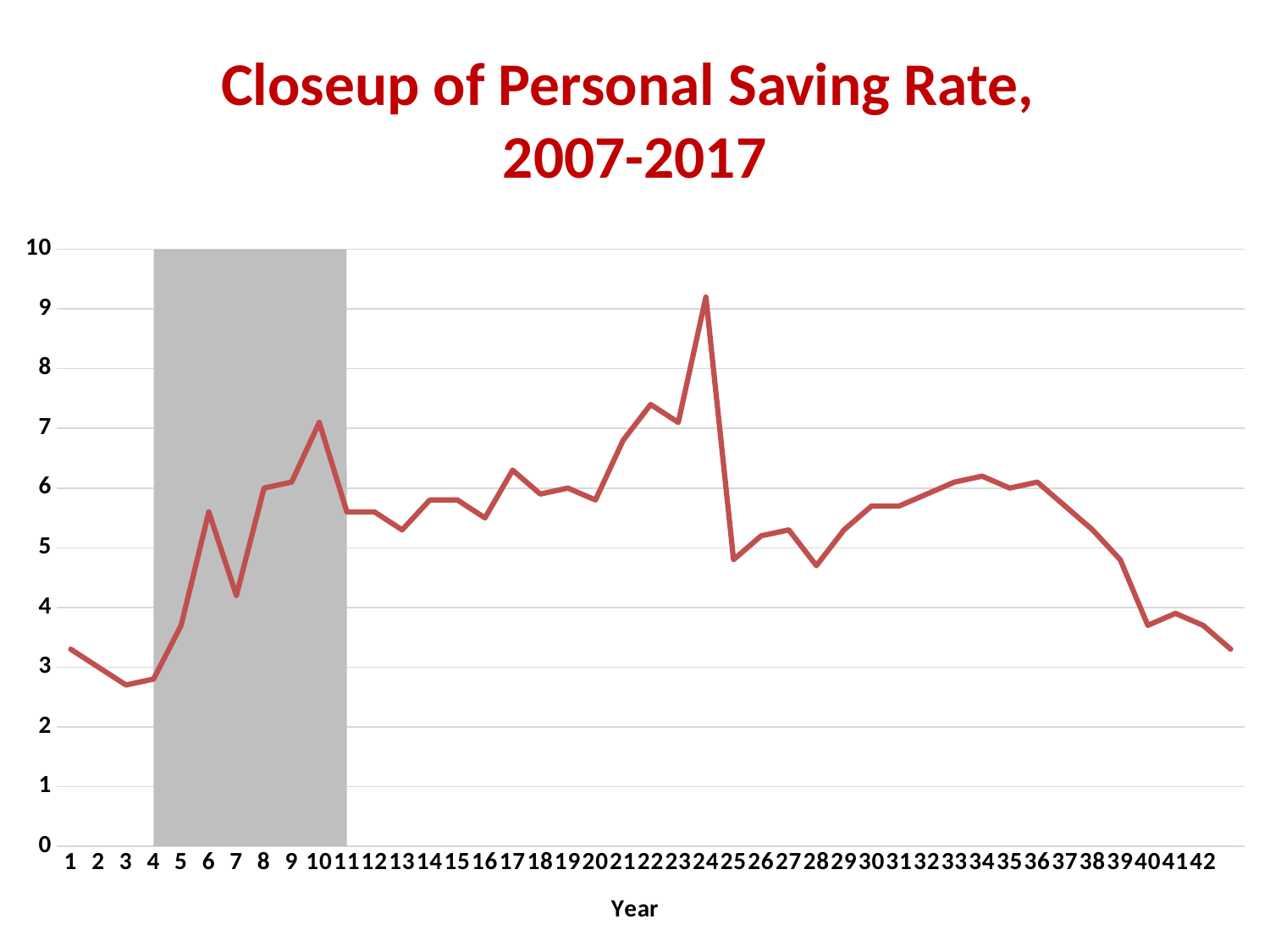
Is the value at point 28 greater or less than 5? less What is the label on the x axis? Year What kind of chart is shown on the slide? line chart Do the values rise or fall from point 36 to point 42? fall Is the value at point 24 greater or less than 8? greater At which x-axis point does the line reach its highest value? 24 What is the title of the chart? Closeup of Personal Saving Rate, 2007-2017 Which has the larger value, point 24 or point 10? point 24 How many points are plotted along the x axis? 43 Is the value at point 10 greater or less than 6? greater Which has the larger value, point 6 or point 7? point 6